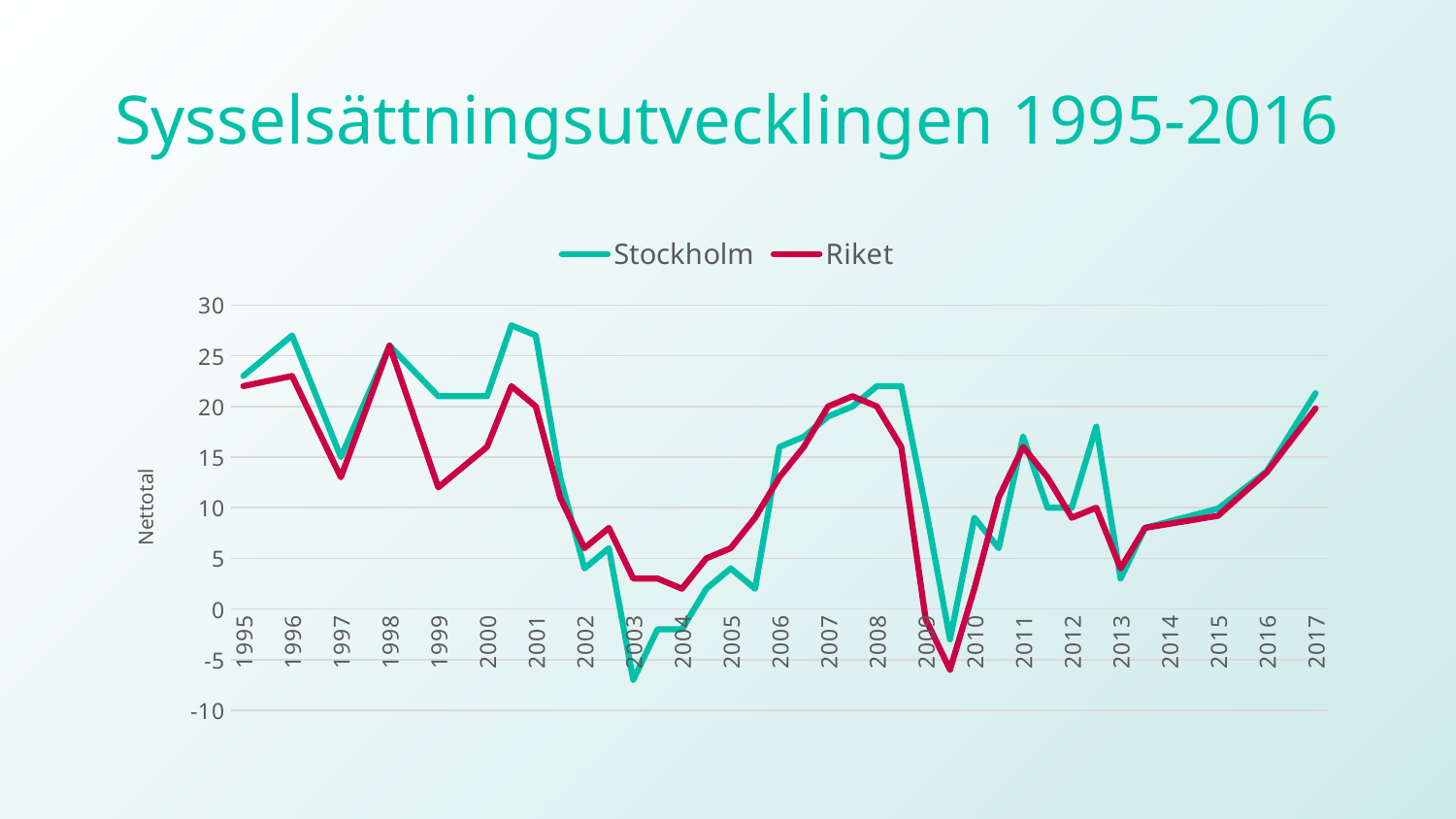
What is the label on the vertical axis? Nettotal Is the value for Riket in 1999 greater or less than 15? less In which year does the Stockholm line reach its lowest value? 2003 Which series has the larger value in 2003, Stockholm or Riket? Riket In which year does the Riket line reach its highest value? 1998 What are the two series named in the legend? Stockholm and Riket How many series does the legend list? 2 In which year does the Riket line reach its lowest value? 2009 Which series has the larger value in 1999, Stockholm or Riket? Stockholm What kind of chart is shown on the slide? line chart How many year labels are shown along the x axis? 23 Is the value for Stockholm in 1995 greater or less than 20? greater